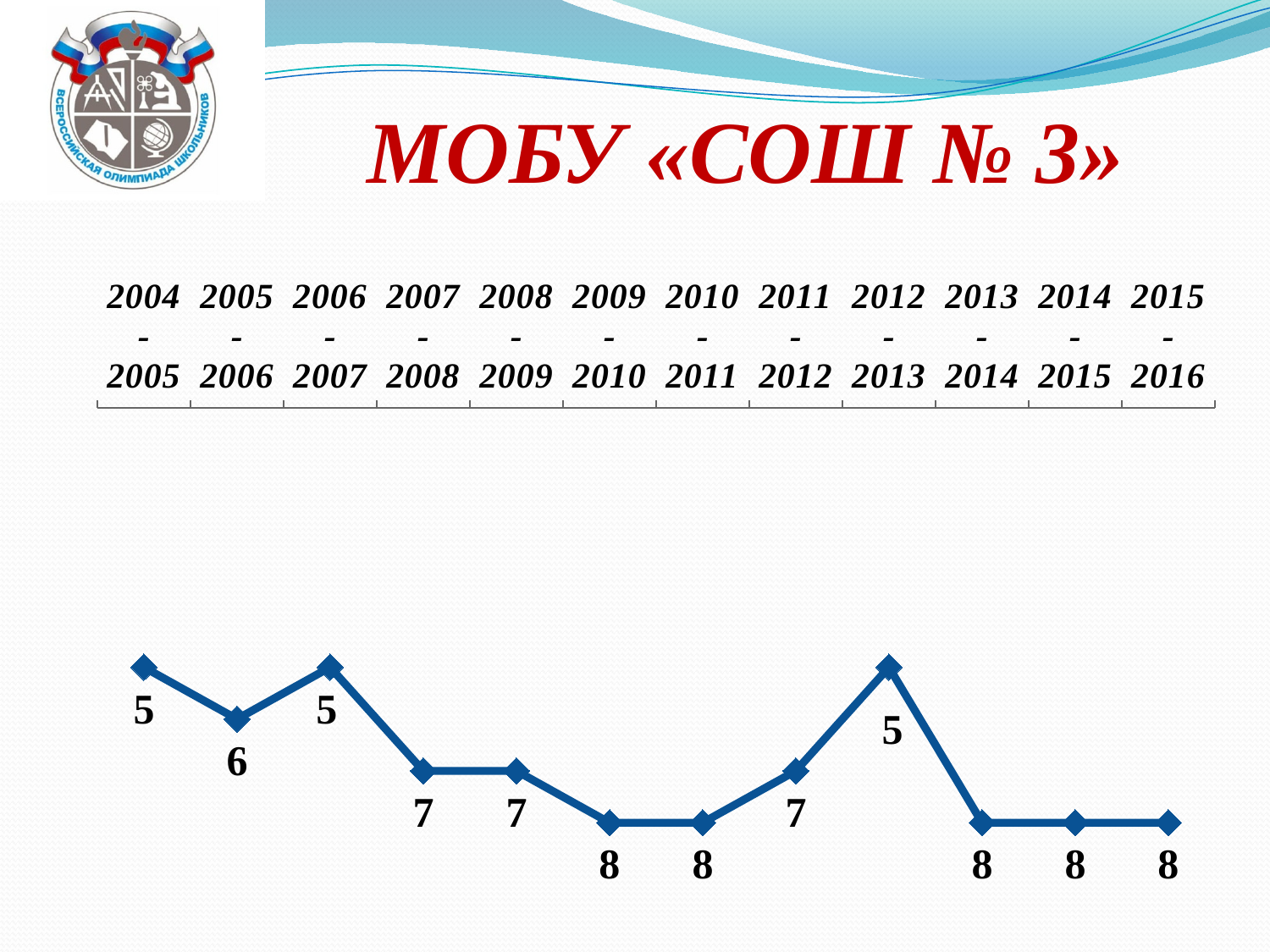
What is the highest value labelled on the chart? 8 What is the value for 2005-2006? 6 What is the value for 2007-2008? 7 What is the difference between the values for 2009-2010 and 2012-2013? 3 What is the value for 2015-2016? 8 What is the value for 2012-2013? 5 What type of chart is shown on the slide? line chart How many data points are plotted on the line chart? 12 What is the value for 2004-2005? 5 What is the lowest value labelled on the chart? 5 What is the title of the slide with the chart? МОБУ «СОШ № 3» Which has the larger value, 2005-2006 or 2011-2012? 2011-2012